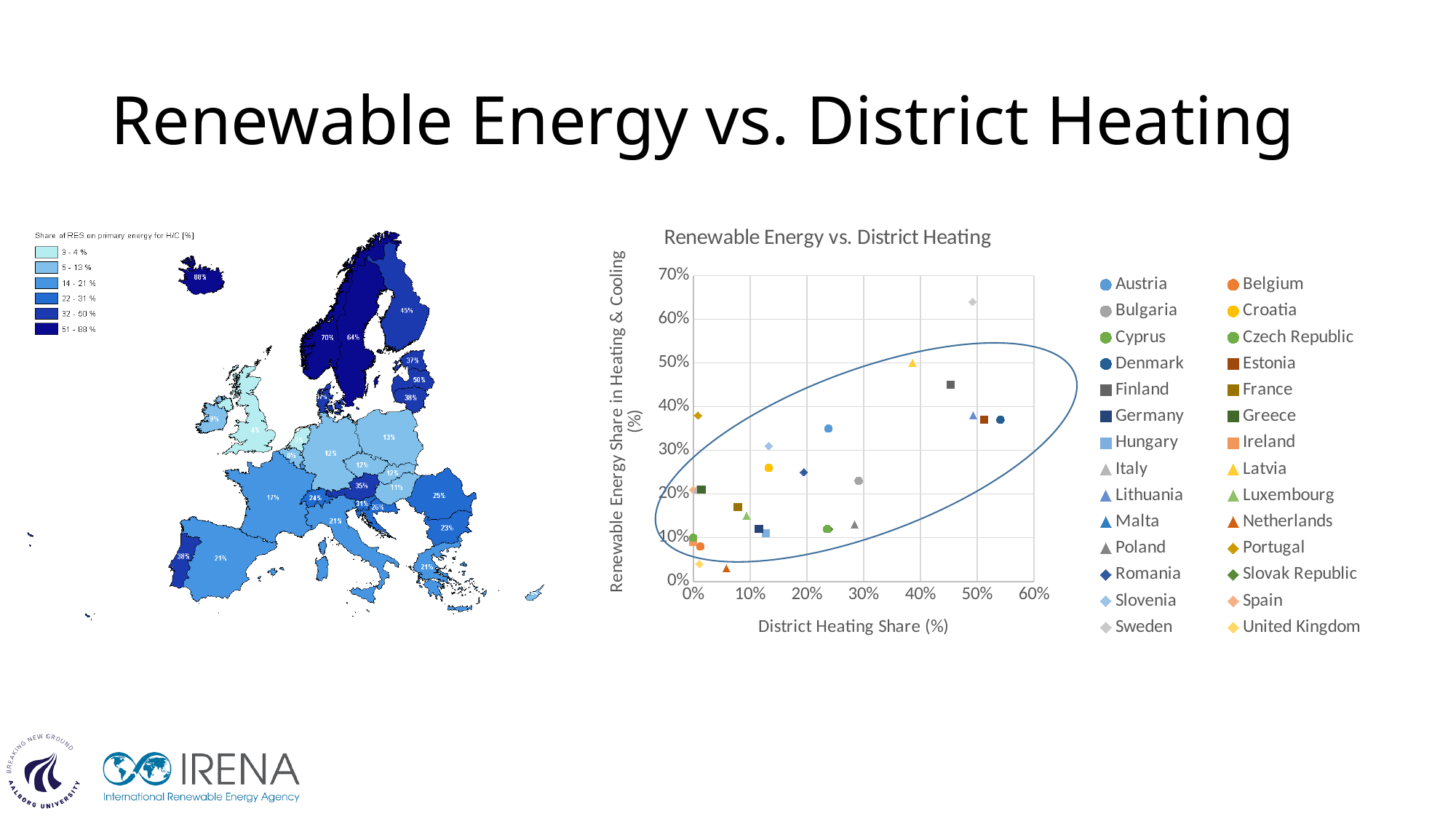
In the scatter chart, is Austria's district heating share greater or less than 20%? greater In the scatter chart, is Finland's renewable energy share in heating and cooling greater or less than 40%? greater What kind of chart is the 'Renewable Energy vs. District Heating' chart on the right of the slide? scatter chart In the scatter chart, is Portugal's renewable energy share in heating and cooling greater or less than 30%? greater How many countries does the legend of the scatter chart list? 28 In the scatter chart, which country has the highest renewable energy share in heating and cooling? Sweden In the scatter chart, which has the larger renewable energy share in heating and cooling, Austria or Bulgaria? Austria What is the title of the scatter chart on the right of the slide? Renewable Energy vs. District Heating What is the label of the x axis of the scatter chart? District Heating Share (%)